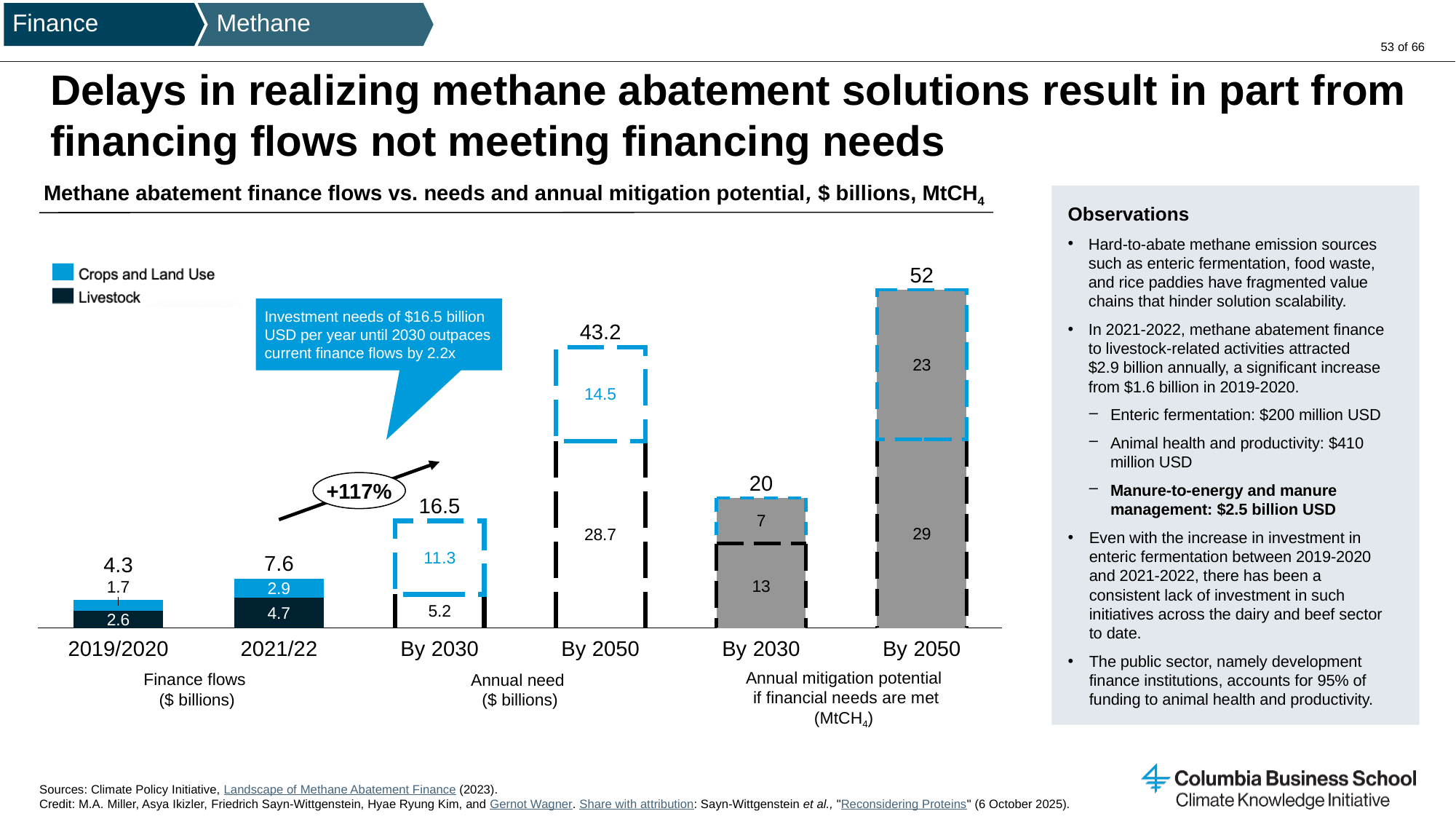
By what percentage did finance flows increase from 2021/22 to the annual need by 2030, according to the annotation on the chart? +117% What is the difference between the total annual need by 2050 and the total annual need by 2030? 26.7 Which is larger: the Livestock value for the annual need by 2030 or the Crops and Land Use value for the annual need by 2030? Crops and Land Use (11.3) What is the total finance flow shown for 2021/22? 7.6 How many series does the legend list? 2 Which bar in the chart has the lowest total value? 2019/2020 What kind of chart is shown on the slide? Stacked bar chart What is the Crops and Land Use value for the annual need by 2050? 14.5 How many bars are plotted in the chart? 6 What is the Livestock value for the 2019/2020 finance flows bar? 2.6 What is the total annual mitigation potential by 2050 if financial needs are met? 52 Which bar in the chart has the highest total value? By 2050 (Annual mitigation potential)